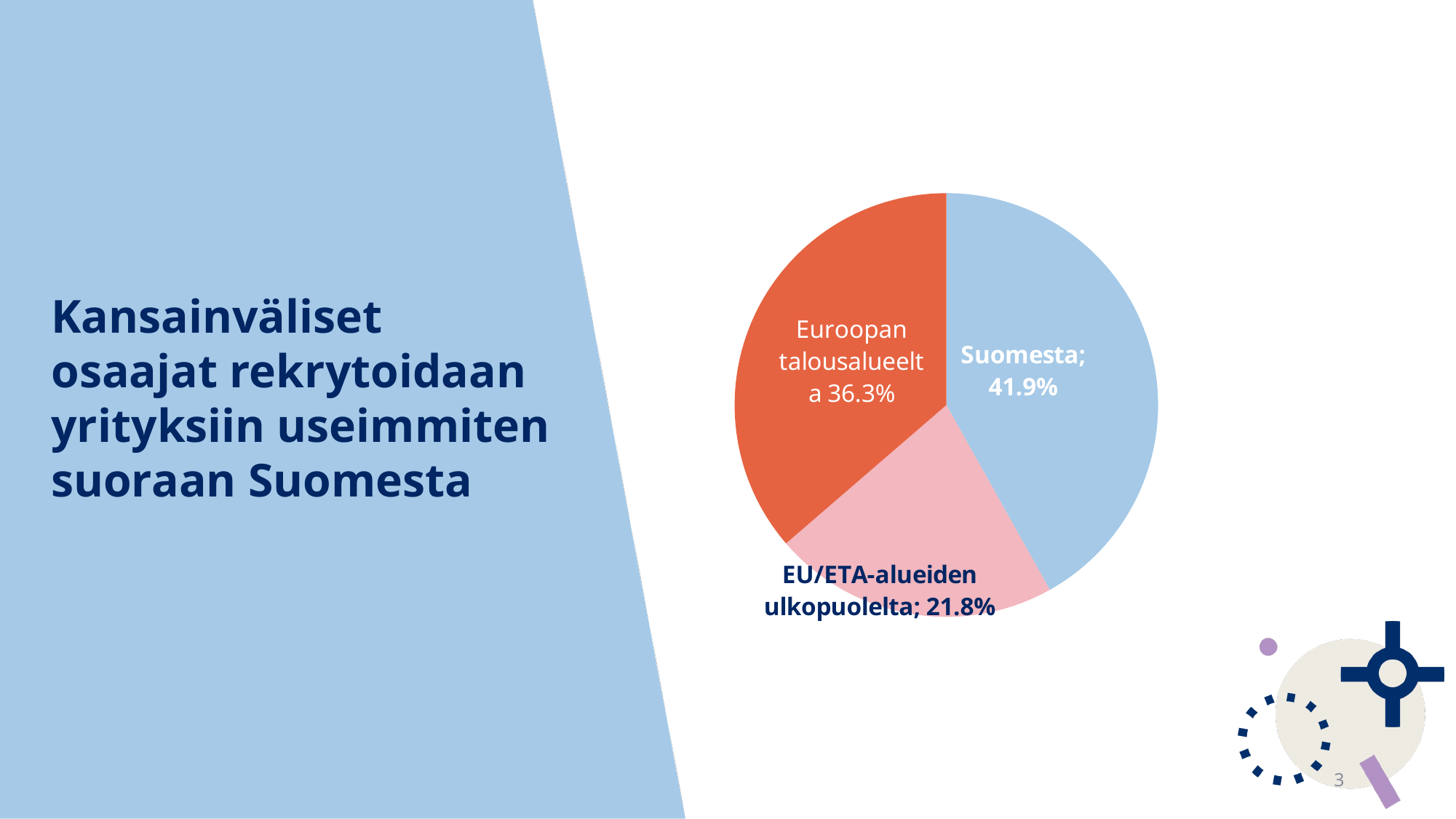
Which slice of the pie chart is the largest? Suomesta What share of the pie is labelled "Suomesta"? 41.9% How many slices does the pie chart have? 3 What share of the pie is labelled "Euroopan talousalueelta"? 36.3% What colour is the "Suomesta" slice of the pie chart? light blue What kind of chart is shown on the slide? pie chart What is the difference in percentage points between the "Euroopan talousalueelta" slice and the "EU/ETA-alueiden ulkopuolelta" slice? 14.5 Which is larger: the "Euroopan talousalueelta" slice or the "EU/ETA-alueiden ulkopuolelta" slice? Euroopan talousalueelta What share of the pie is labelled "EU/ETA-alueiden ulkopuolelta"? 21.8% Which slice of the pie chart is the smallest? EU/ETA-alueiden ulkopuolelta What colour is the "Euroopan talousalueelta" slice of the pie chart? orange-red What is the difference in percentage points between the "Suomesta" slice and the "Euroopan talousalueelta" slice? 5.6